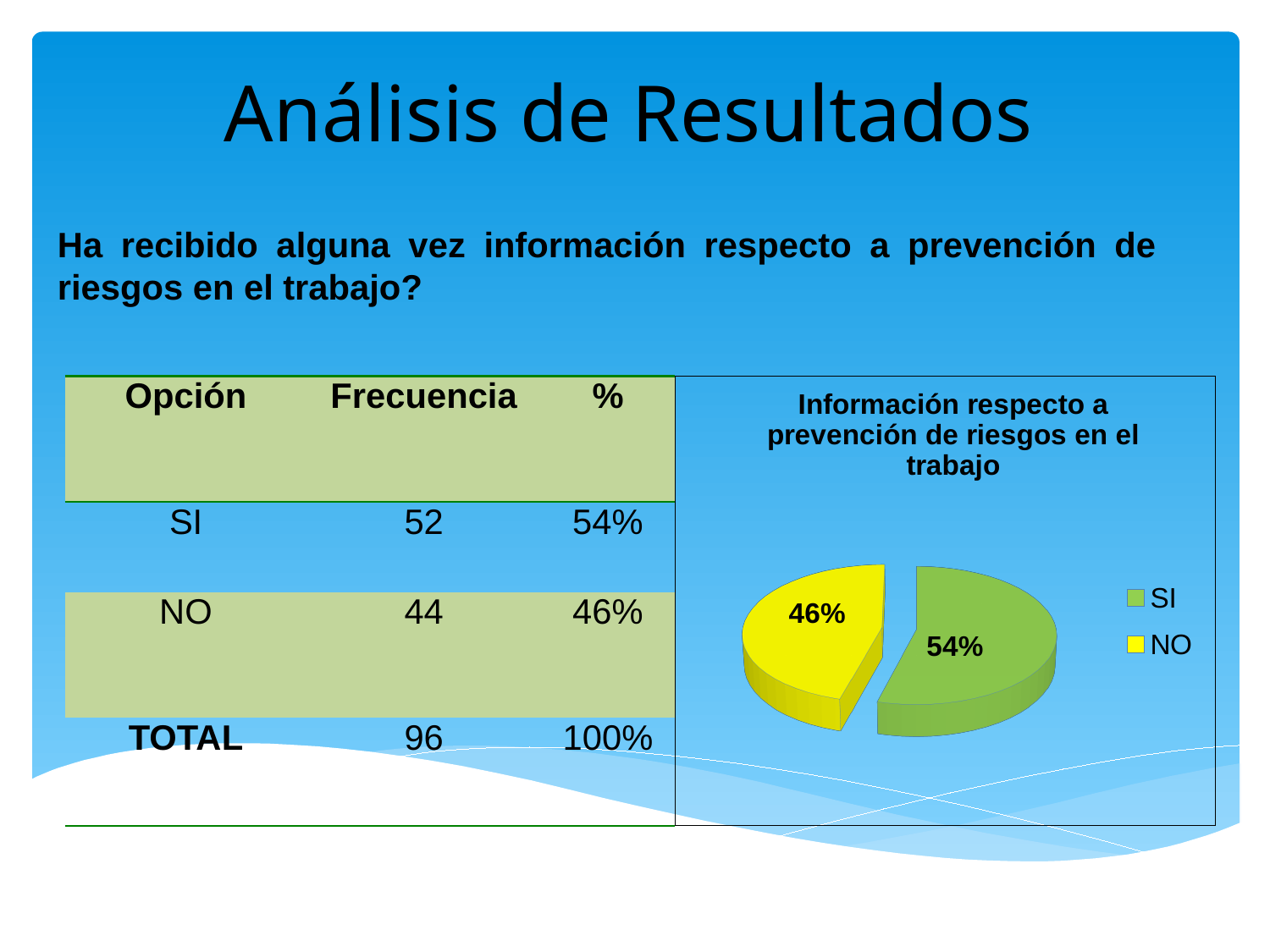
What is the difference in percentage points between the SI and NO slices? 8 What is the chart's title? Información respecto a prevención de riesgos en el trabajo How many slices does the pie chart have? 2 Which slice of the pie chart is the smallest? NO What kind of chart is shown on the slide? pie chart What share of the pie does the SI slice represent? 54% Which is larger in the pie chart, SI or NO? SI What percentage does the SI slice show in the pie chart? 54% What colour is the NO slice in the pie chart? yellow How many entries does the legend list? 2 Which slice of the pie chart is the largest? SI What percentage does the NO slice show in the pie chart? 46%